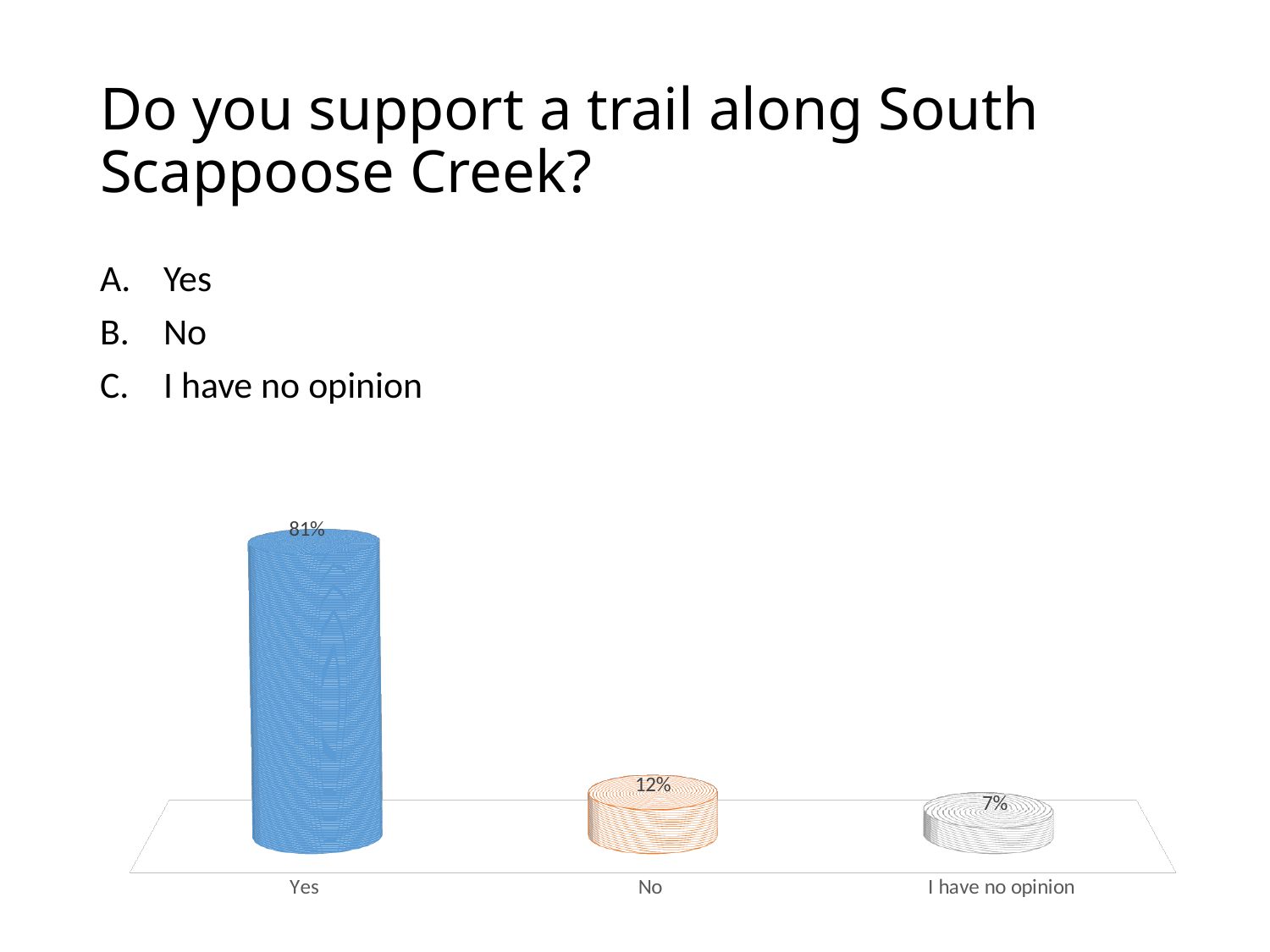
What colour is the bar for "Yes"? Blue Which is larger, the value for "No" or the value for "I have no opinion"? No What is the difference in percentage points between "Yes" and "No"? 69 What is the difference in percentage points between "No" and "I have no opinion"? 5 Do the values rise or fall moving from left to right across the categories? Fall What kind of chart is shown on the slide? Bar chart Which response has the highest percentage? Yes What percentage of respondents answered "I have no opinion"? 7% How many response categories are shown in the chart? 3 Which response has the lowest percentage? I have no opinion What percentage of respondents answered "Yes"? 81% What percentage of respondents answered "No"? 12%